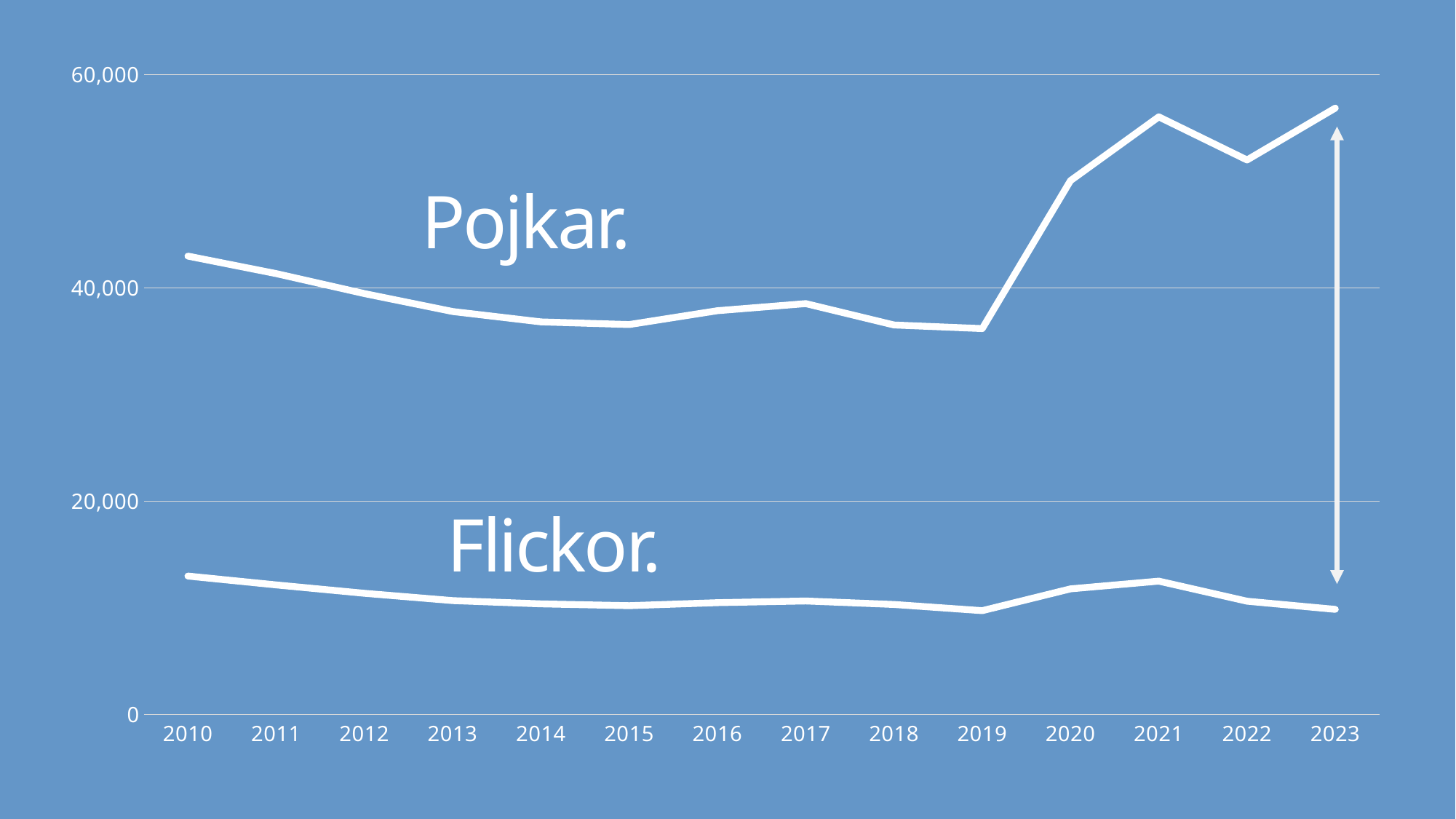
Is the value for Pojkar in 2019 greater or less than 40,000? less How many years are shown along the x axis? 14 Does the Pojkar line rise or fall between 2010 and 2019? fall How many series are plotted on the chart? 2 For Pojkar, which year has the larger value, 2019 or 2023? 2023 What kind of chart is shown on the slide? line chart What are the two series labels written on the chart? Pojkar. and Flickor. Which series has the larger value in 2023, Pojkar or Flickor? Pojkar Is the value for Pojkar in 2023 greater or less than 60,000? less Is the value for Pojkar in 2010 greater or less than 40,000? greater